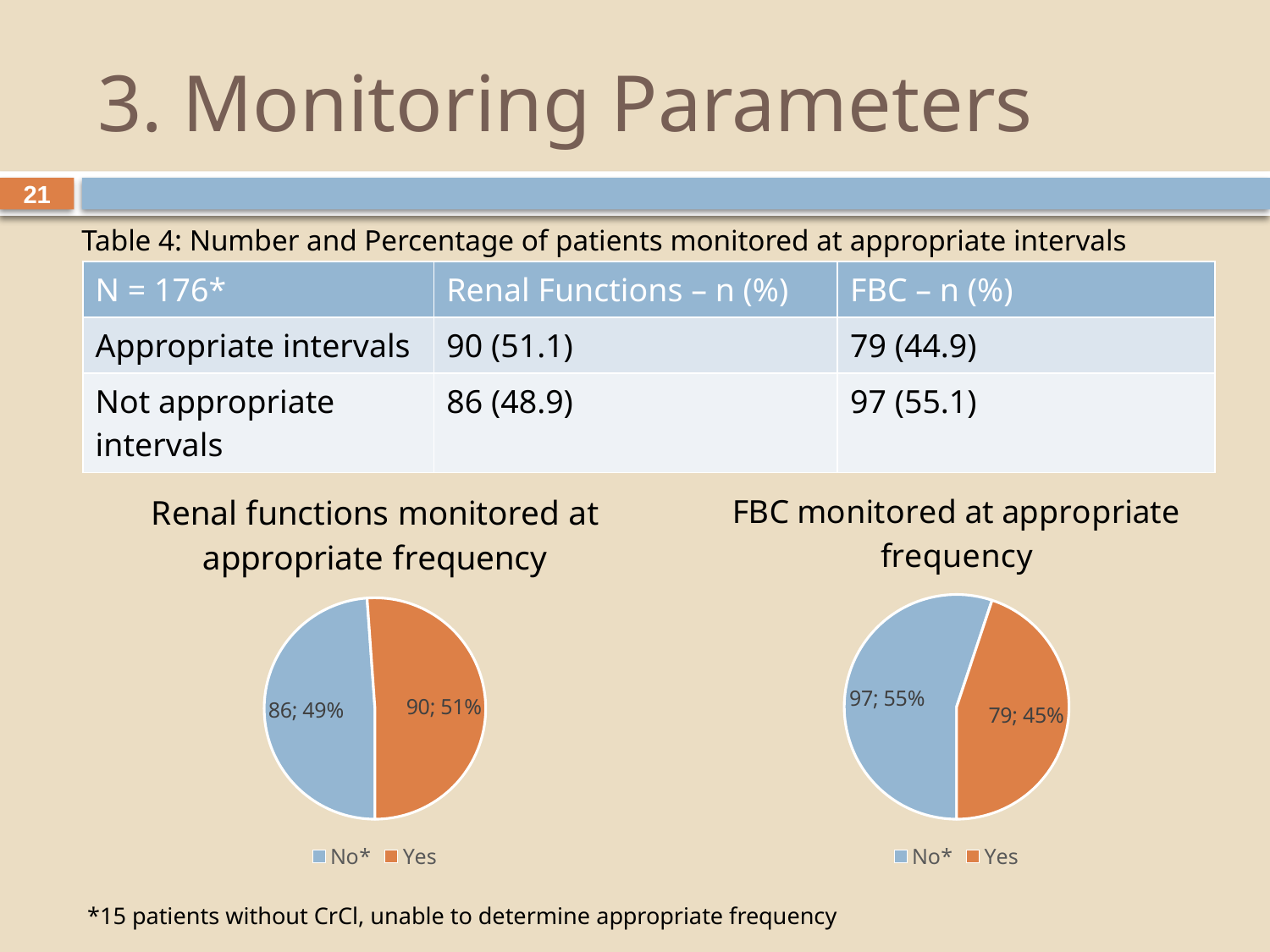
In the chart titled "FBC monitored at appropriate frequency", what percentage share does the "Yes" slice have? 45% In the chart titled "Renal functions monitored at appropriate frequency", which slice is the smallest? No* In the chart titled "FBC monitored at appropriate frequency", which slice is larger, "Yes" or "No*"? No* In the chart titled "FBC monitored at appropriate frequency", what is the number of patients in the "No*" slice? 97 In the chart titled "Renal functions monitored at appropriate frequency", what is the number of patients in the "Yes" slice? 90 In the chart titled "Renal functions monitored at appropriate frequency", what percentage share does the "No*" slice have? 49% How many entries does the legend of the chart titled "FBC monitored at appropriate frequency" list? 2 What kind of chart is the chart titled "Renal functions monitored at appropriate frequency"? Pie chart In the chart titled "FBC monitored at appropriate frequency", what is the difference in patient numbers between the "No*" and "Yes" slices? 18 In the chart titled "FBC monitored at appropriate frequency", which slice is the largest? No* In the chart titled "Renal functions monitored at appropriate frequency", what is the difference in patient numbers between the "Yes" and "No*" slices? 4 In the chart titled "Renal functions monitored at appropriate frequency", what colour is the "Yes" slice? Orange